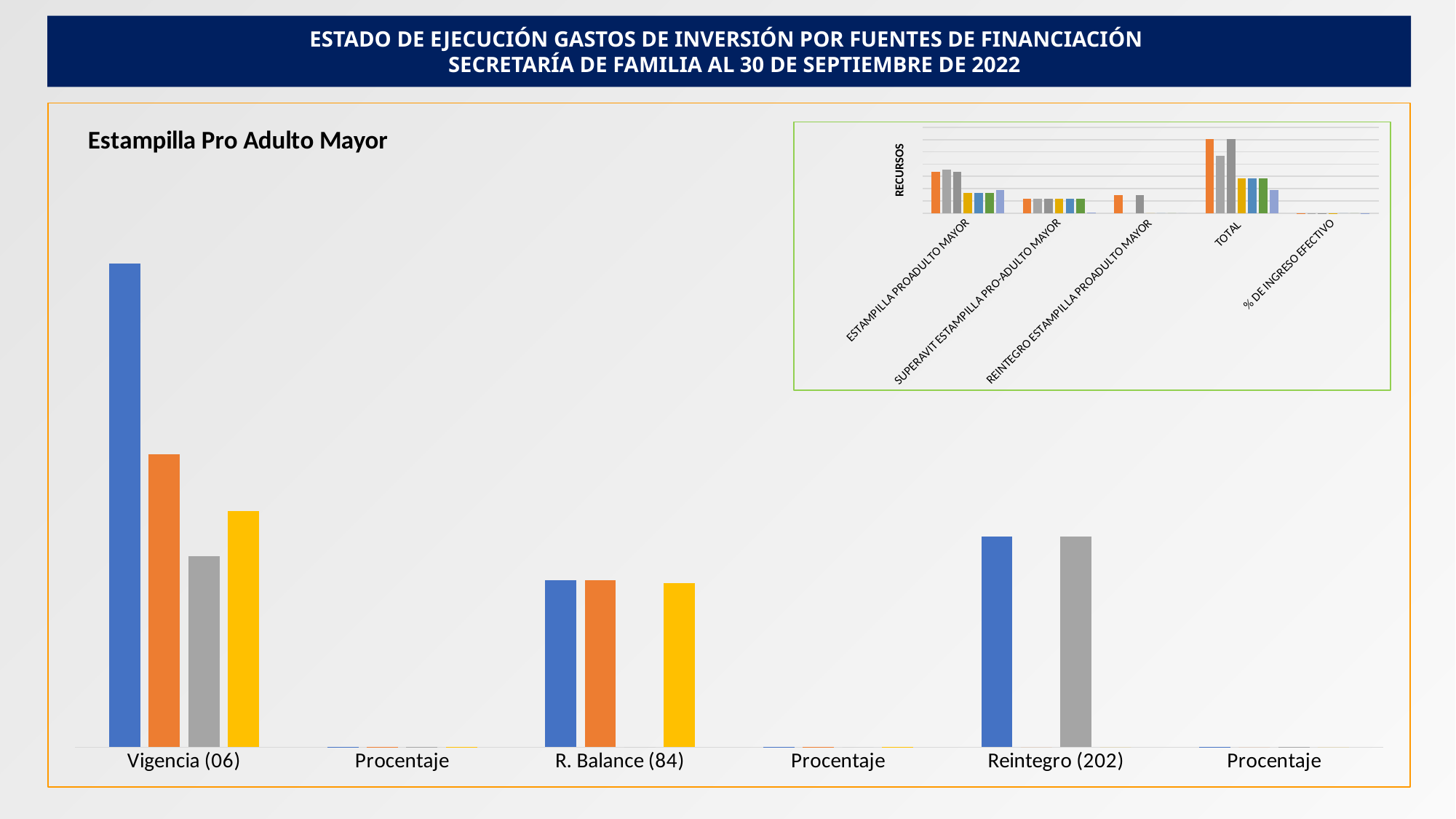
What kind of chart is the small inset chart in the top right of the slide? bar chart In the 'Estampilla Pro Adulto Mayor' chart, is the blue bar for Vigencia (06) taller or shorter than the blue bar for Reintegro (202)? taller In the 'Estampilla Pro Adulto Mayor' chart, which category has the tallest bar? Vigencia (06) What is the title of the large chart on the left of the slide? Estampilla Pro Adulto Mayor How many categories are shown on the x axis of the 'Estampilla Pro Adulto Mayor' chart? 6 In the 'Estampilla Pro Adulto Mayor' chart, is the orange bar for Vigencia (06) taller or shorter than the orange bar for R. Balance (84)? taller In the small inset chart in the top right, which category has the tallest bar? TOTAL In the 'Estampilla Pro Adulto Mayor' chart, which bar in the Vigencia (06) group is the tallest? the blue bar What kind of chart is the large 'Estampilla Pro Adulto Mayor' chart? bar chart In the 'Estampilla Pro Adulto Mayor' chart, how many bars are visible in the Vigencia (06) group? 4 How many categories are shown on the x axis of the small inset chart in the top right? 5 In the 'Estampilla Pro Adulto Mayor' chart, which bar in the Vigencia (06) group is the shortest? the grey bar